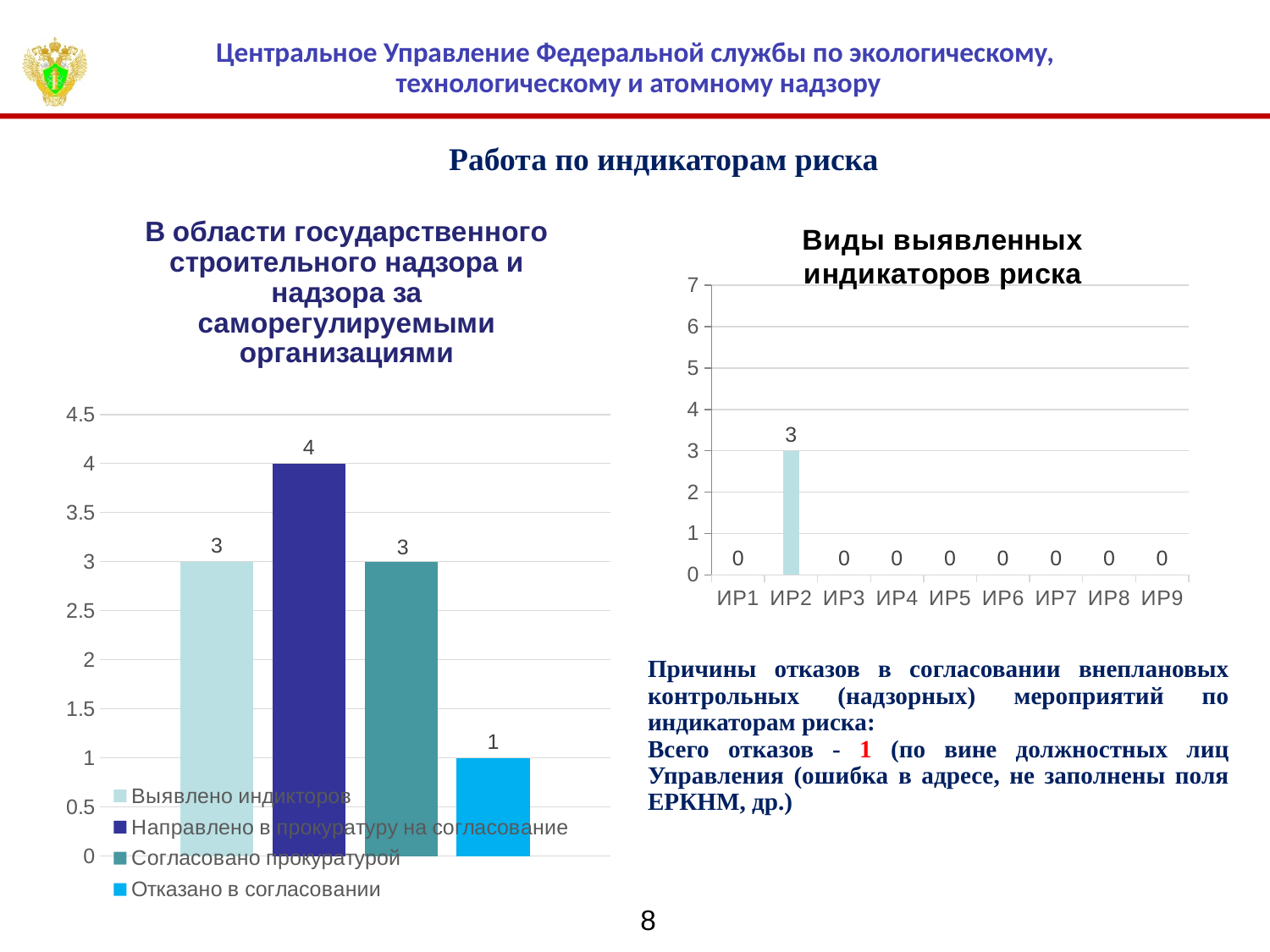
In the left chart 'В области государственного строительного надзора и надзора за саморегулируемыми организациями', which is larger: 'Выявлено индикаторов' or 'Направлено в прокуратуру на согласование'? Направлено в прокуратуру на согласование In the left chart 'В области государственного строительного надзора и надзора за саморегулируемыми организациями', what is the difference between 'Направлено в прокуратуру на согласование' and 'Отказано в согласовании'? 3 In the right chart 'Виды выявленных индикаторов риска', how many categories are shown on the x axis? 9 In the right chart 'Виды выявленных индикаторов риска', which category has the highest value? ИР2 In the left chart 'В области государственного строительного надзора и надзора за саморегулируемыми организациями', which series has the highest value? Направлено в прокуратуру на согласование What kind of chart is the right chart 'Виды выявленных индикаторов риска'? Bar chart In the left chart 'В области государственного строительного надзора и надзора за саморегулируемыми организациями', what is the value for 'Направлено в прокуратуру на согласование'? 4 In the left chart 'В области государственного строительного надзора и надзора за саморегулируемыми организациями', what is the value for 'Отказано в согласовании'? 1 In the right chart 'Виды выявленных индикаторов риска', what is the value for ИР5? 0 In the left chart 'В области государственного строительного надзора и надзора за саморегулируемыми организациями', which series has the lowest value? Отказано в согласовании In the right chart 'Виды выявленных индикаторов риска', what is the value for ИР2? 3 In the left chart 'В области государственного строительного надзора и надзора за саморегулируемыми организациями', how many series does the legend list? 4